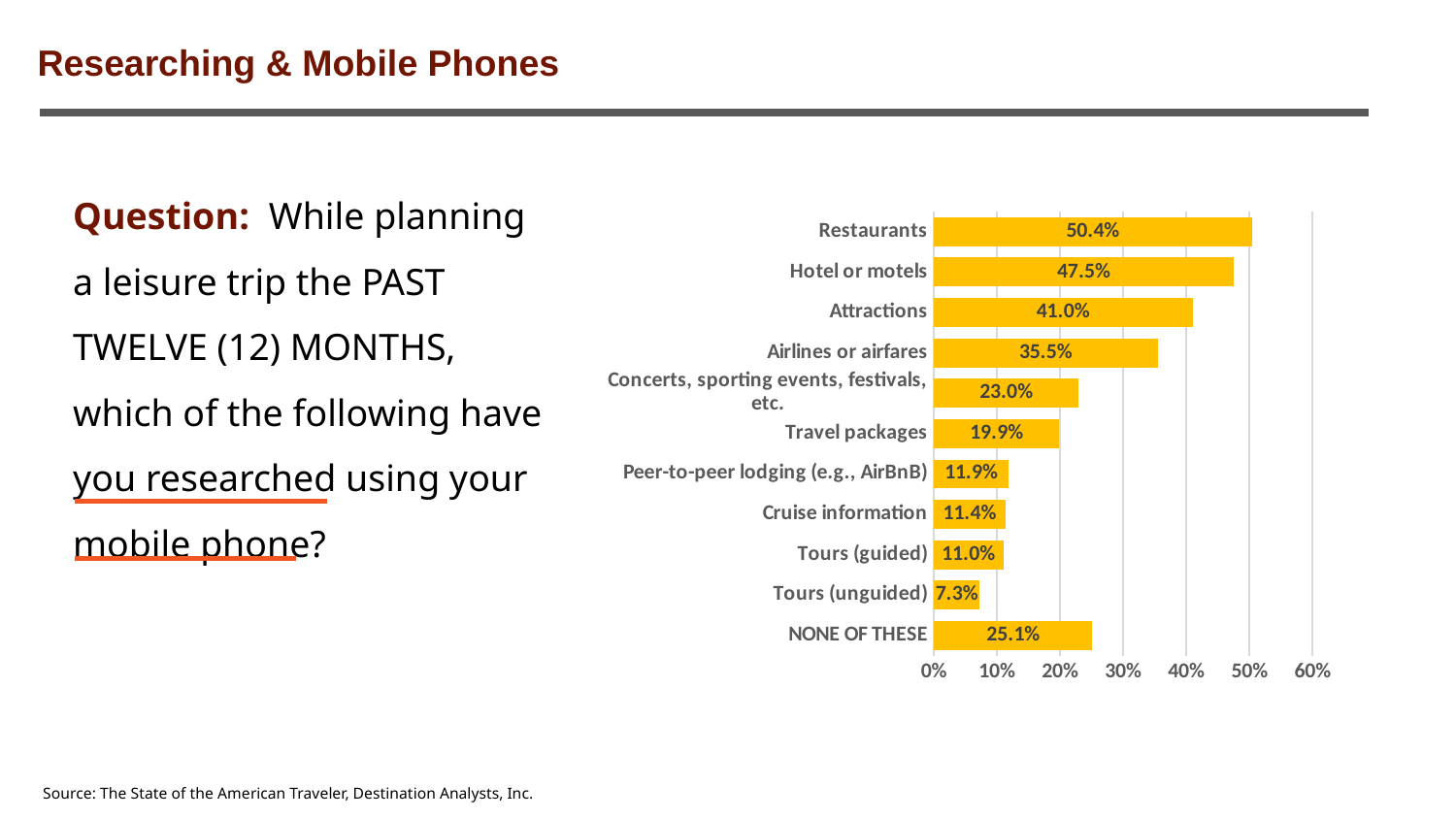
What is the difference between the values for Restaurants and Hotel or motels? 2.9% Which category has the highest value in the chart? Restaurants What percentage of respondents researched Restaurants using their mobile phone? 50.4% What is the value shown for Airlines or airfares? 35.5% What is the maximum value shown on the chart's percentage axis? 60% What type of chart is shown on the slide? Bar chart Which category has the lowest value in the chart? Tours (unguided) What is the value shown for NONE OF THESE? 25.1% Is the value for Hotel or motels greater or less than 40%? greater What is the difference between the values for Attractions and Travel packages? 21.1% How many categories are shown in the chart? 11 Which is larger, the value for Concerts, sporting events, festivals, etc. or the value for Travel packages? Concerts, sporting events, festivals, etc.